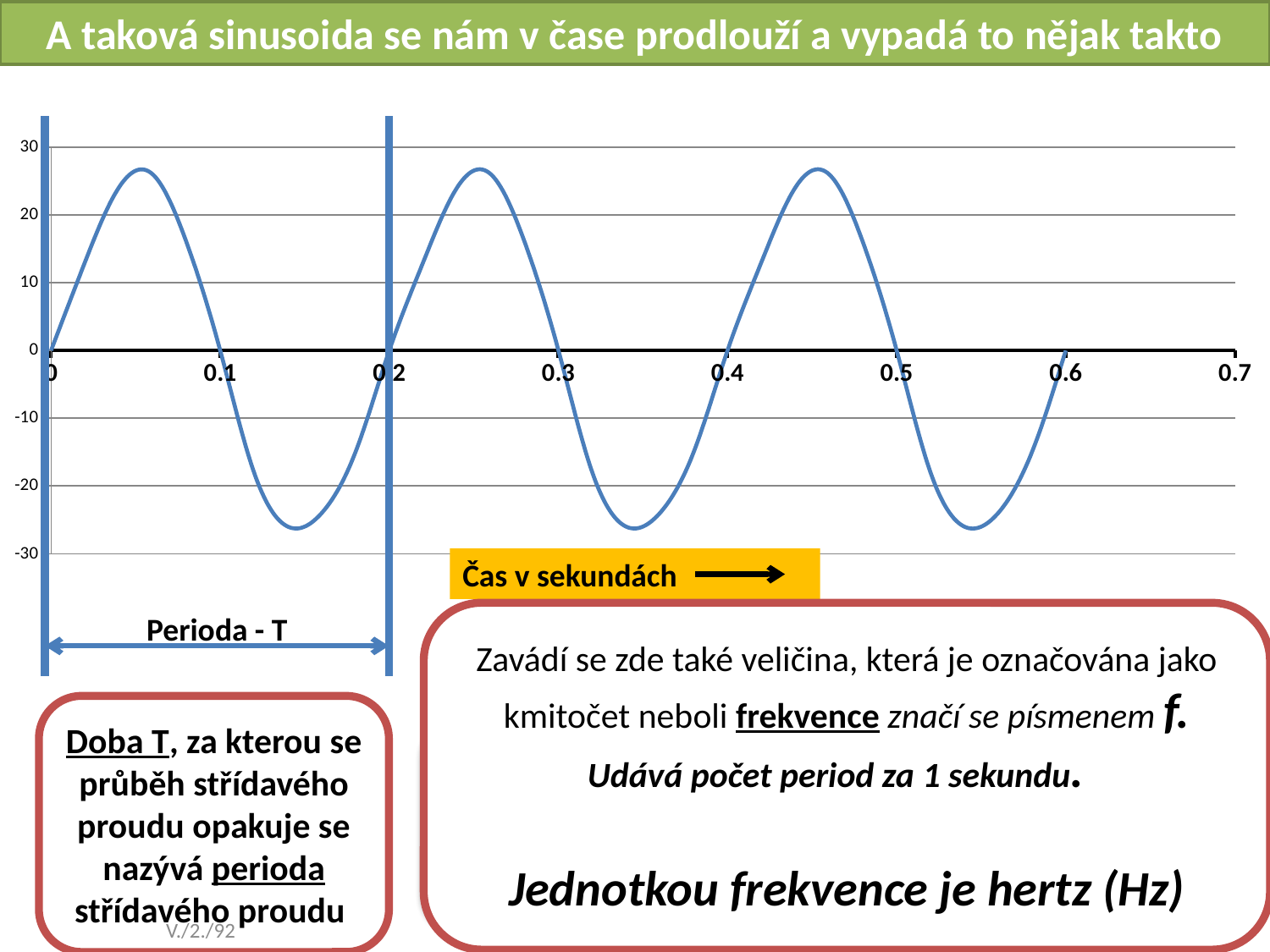
Is the peak value of the curve near x = 0.05 greater or less than 20? greater What is the value of the curve at x = 0.1? 0 How many complete periods of the sine wave are plotted on the chart? 3 What is the highest value shown on the y axis? 30 Between x = 0.05 and x = 0.15, does the curve rise or fall? fall What is the label of the x axis shown in the yellow box? Čas v sekundách Between x = 0 and x = 0.05, does the curve rise or fall? rise Is the value of the curve at x = 0.45 greater or less than 10? greater Is the peak value of the curve near x = 0.05 greater or less than 30? less What is the value of the curve at x = 0.3? 0 What kind of chart is shown on the slide? line chart